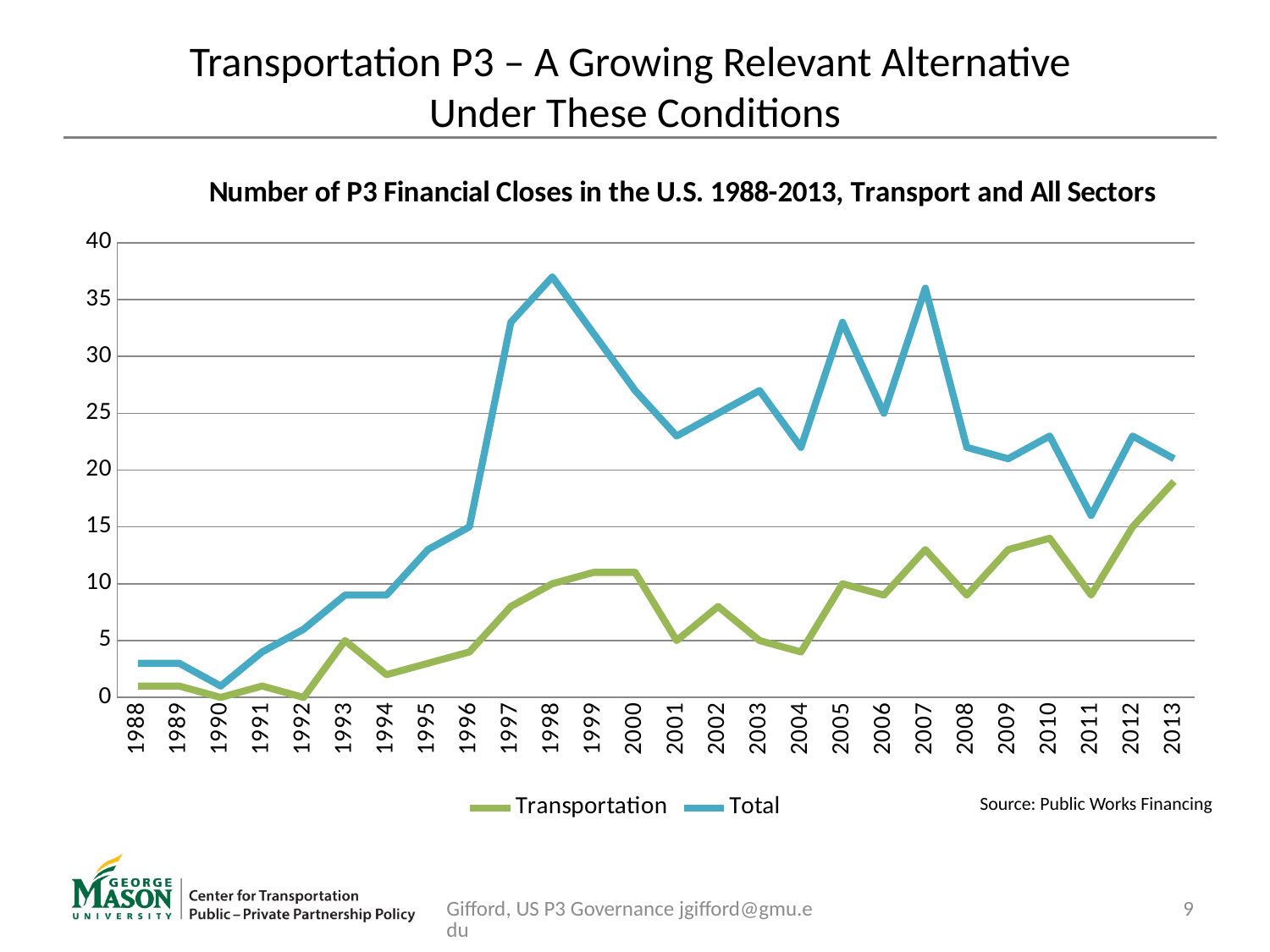
What is the Transportation value in 2005? 10 In which year is the Total series at its lowest? 1990 Which series has the larger value in 2000, Transportation or Total? Total What is the Total value in 1996? 15 How many years are plotted along the x axis? 26 What kind of chart is shown on the slide? Line chart What is the Transportation value in 1993? 5 In which year is the Transportation series at its highest? 2013 Is the Total value for 1990 greater or less than 5? less How many series does the legend list? 2 Is the Transportation value for 2013 greater or less than 15? greater Is the Total value for 1998 greater or less than 35? greater